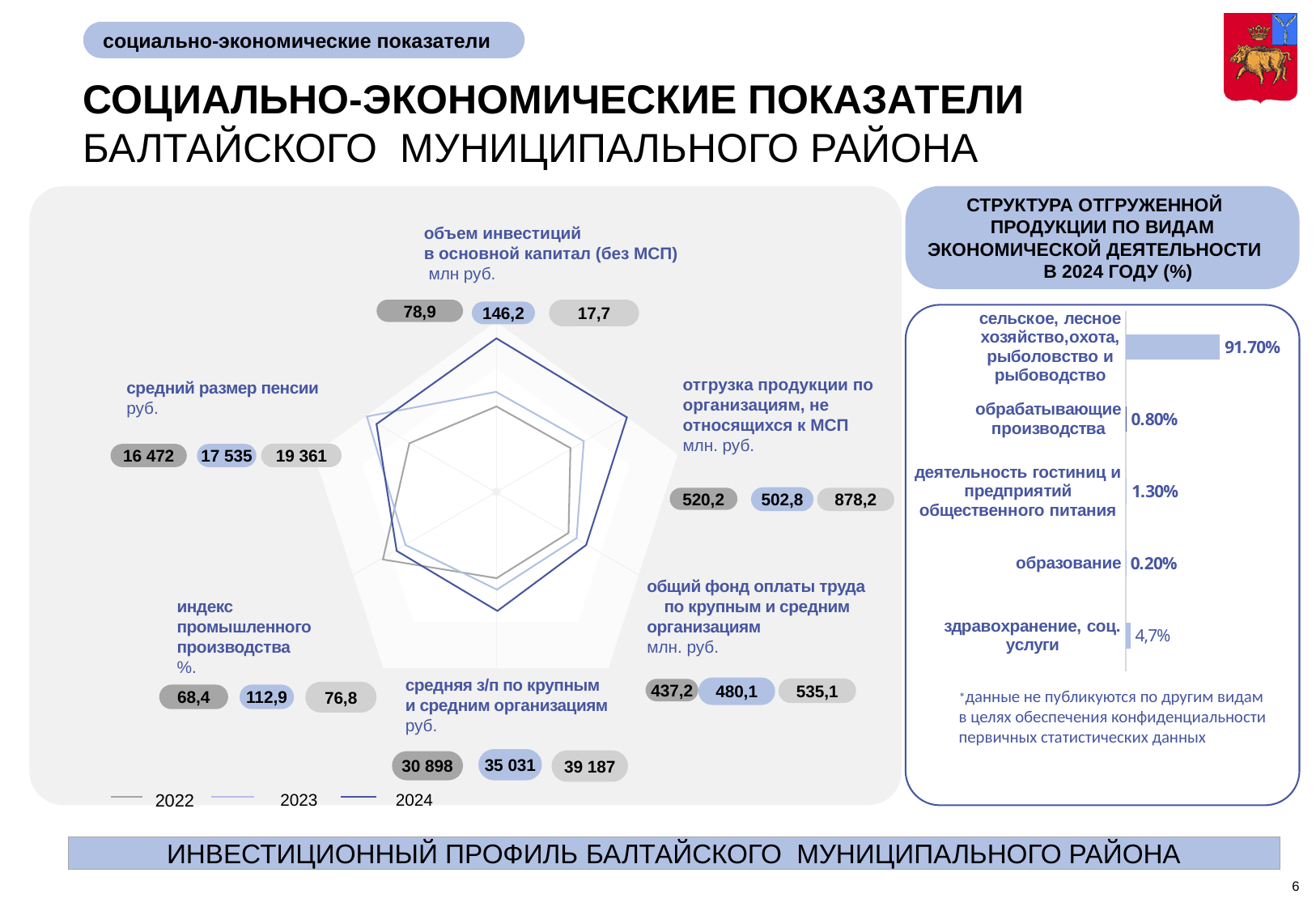
What type of chart is shown on the right side of the slide, under the title 'Структура отгруженной продукции по видам экономической деятельности в 2024 году (%)'? bar chart In the bar chart on the right, what is the value for 'здравоохранение, соц. услуги'? 4,7% In the bar chart on the right, which category has the highest value? сельское, лесное хозяйство, охота, рыболовство и рыбоводство In the bar chart on the right, what is the difference between the values for 'деятельность гостиниц и предприятий общественного питания' and 'обрабатывающие производства'? 0.50% In the radar chart on the left, how many indicators (axes) are plotted? 6 In the radar chart on the left, what is the 2024 value for 'отгрузка продукции по организациям, не относящихся к МСП' (млн. руб.)? 878,2 In the bar chart on the right, how many categories are shown? 5 In the bar chart on the right, which is larger: the value for 'здравоохранение, соц. услуги' or for 'обрабатывающие производства'? здравоохранение, соц. услуги How many series does the legend of the radar chart on the left list? 3 In the bar chart on the right, what is the value for 'сельское, лесное хозяйство, охота, рыболовство и рыбоводство'? 91.70% In the bar chart on the right, which category has the lowest value? образование What type of chart is shown on the left side of the slide with the socio-economic indicators? radar chart